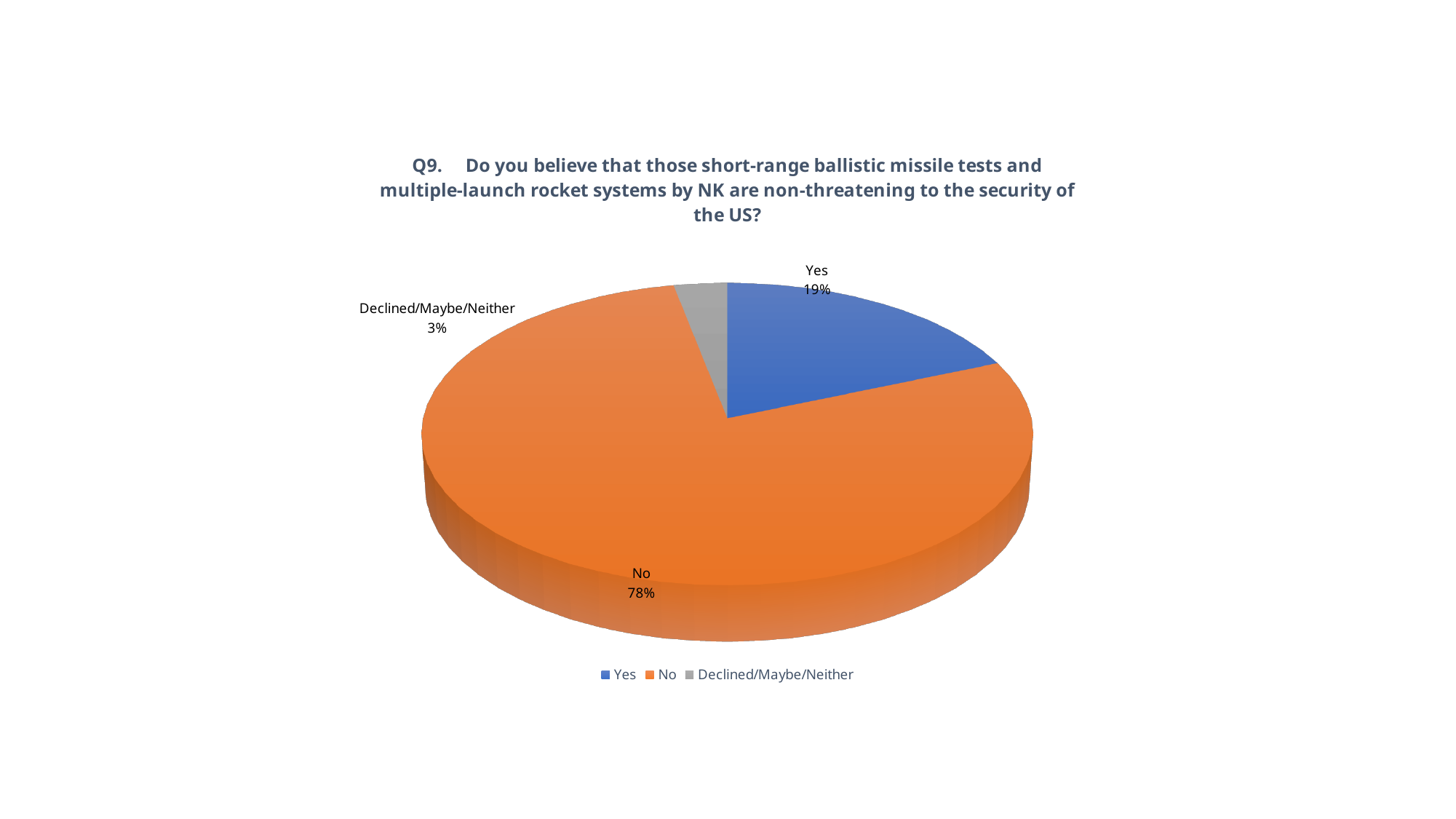
Which response has the largest slice of the pie? No How many entries does the legend list? 3 What percentage of respondents answered "No"? 78% What is the difference in percentage points between the "No" and "Yes" slices? 59 What kind of chart is shown on the slide? Pie chart What share of the pie is labelled "Declined/Maybe/Neither"? 3% Which response has the smallest slice of the pie? Declined/Maybe/Neither What percentage of respondents answered "Yes"? 19% How many slices does the pie chart have? 3 Which slice is larger, "Yes" or "Declined/Maybe/Neither"? Yes What question number is shown at the start of the chart title? Q9 What colour is the "No" slice? Orange